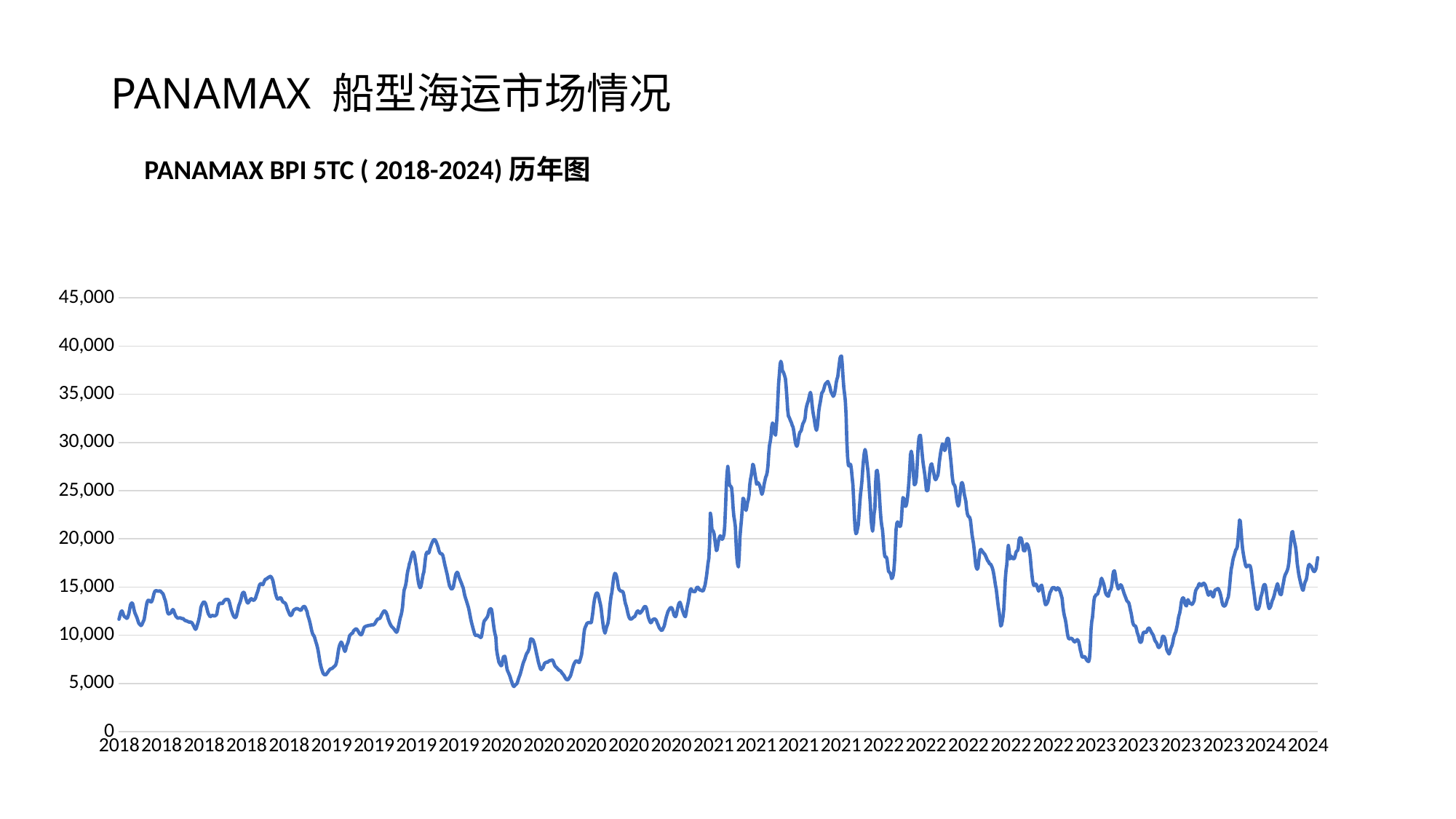
Does the line rise or fall overall from the start of 2020 to the peak in 2021? rise What is the highest value shown on the vertical axis? 45,000 How many lines (series) are plotted on the chart? 1 What kind of chart is shown on the slide? line chart In which year does the line reach its lowest value? 2020 In which year does the line reach its highest value? 2021 Which is higher, the peak value in 2019 or the peak value in 2021? 2021 What is the title of the chart? PANAMAX BPI 5TC ( 2018-2024) 历年图 Is the peak value reached in 2021 greater or less than 35,000? greater Is the lowest value reached in 2020 greater or less than 10,000? less Is the lowest value reached in 2023 greater or less than 10,000? less